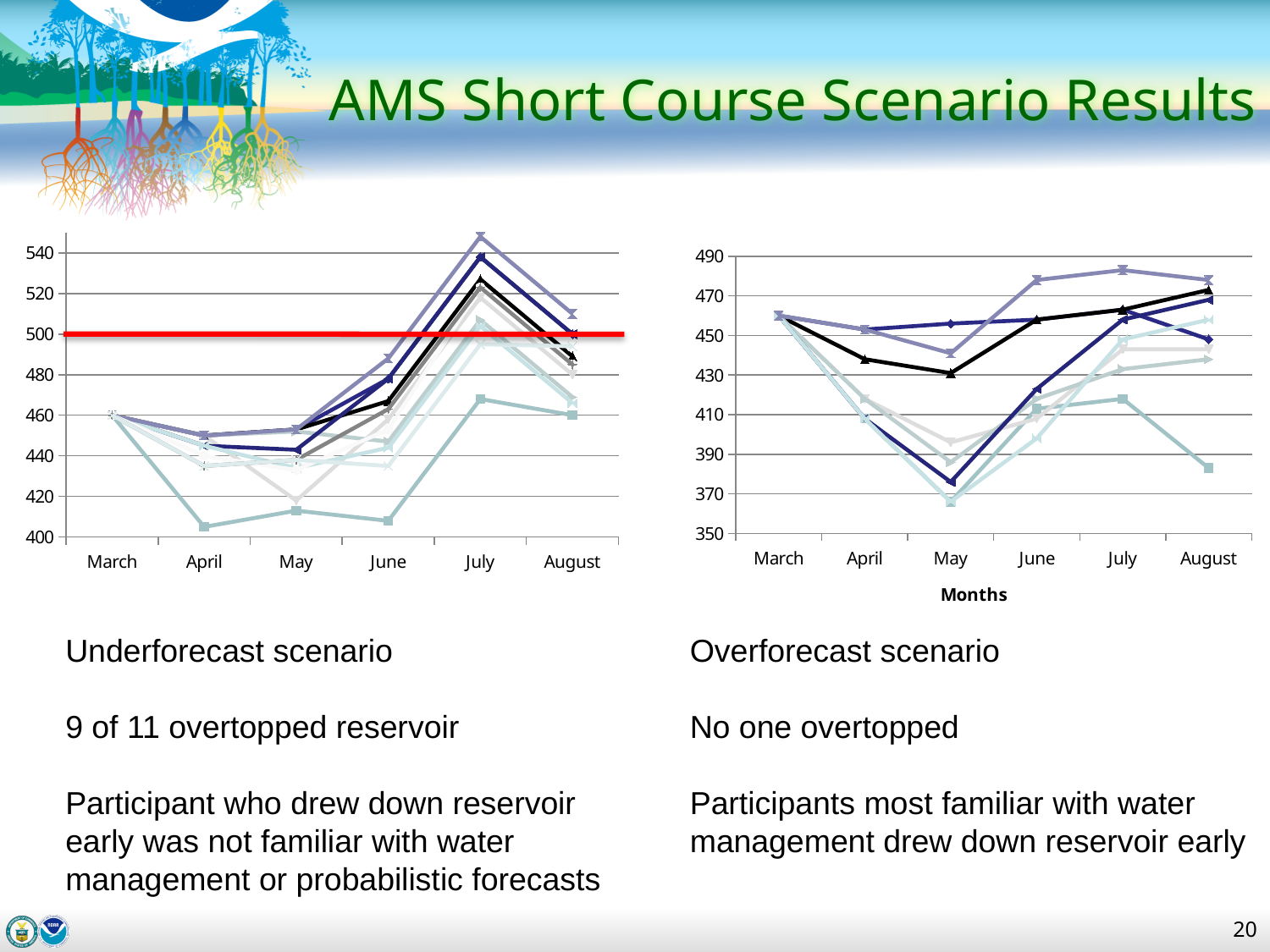
In the right chart, is the highest line's value in July greater or less than 470? greater In the left chart, is the lowest line's value in April greater or less than 420? less What kind of chart is the left chart (Underforecast scenario)? line chart In the right chart, is the lowest line's value in May greater or less than 390? less What is the x-axis title of the right chart? Months In the left chart, do the lines rise or fall from May to July? rise In the left chart, at what value is the red horizontal line drawn? 500 How many months are shown on the x axis of the left chart? 6 What kind of chart is the right chart (Overforecast scenario)? line chart In the left chart, in which month do the lines reach their highest values? July In the right chart, does the black line rise or fall from March to May? fall